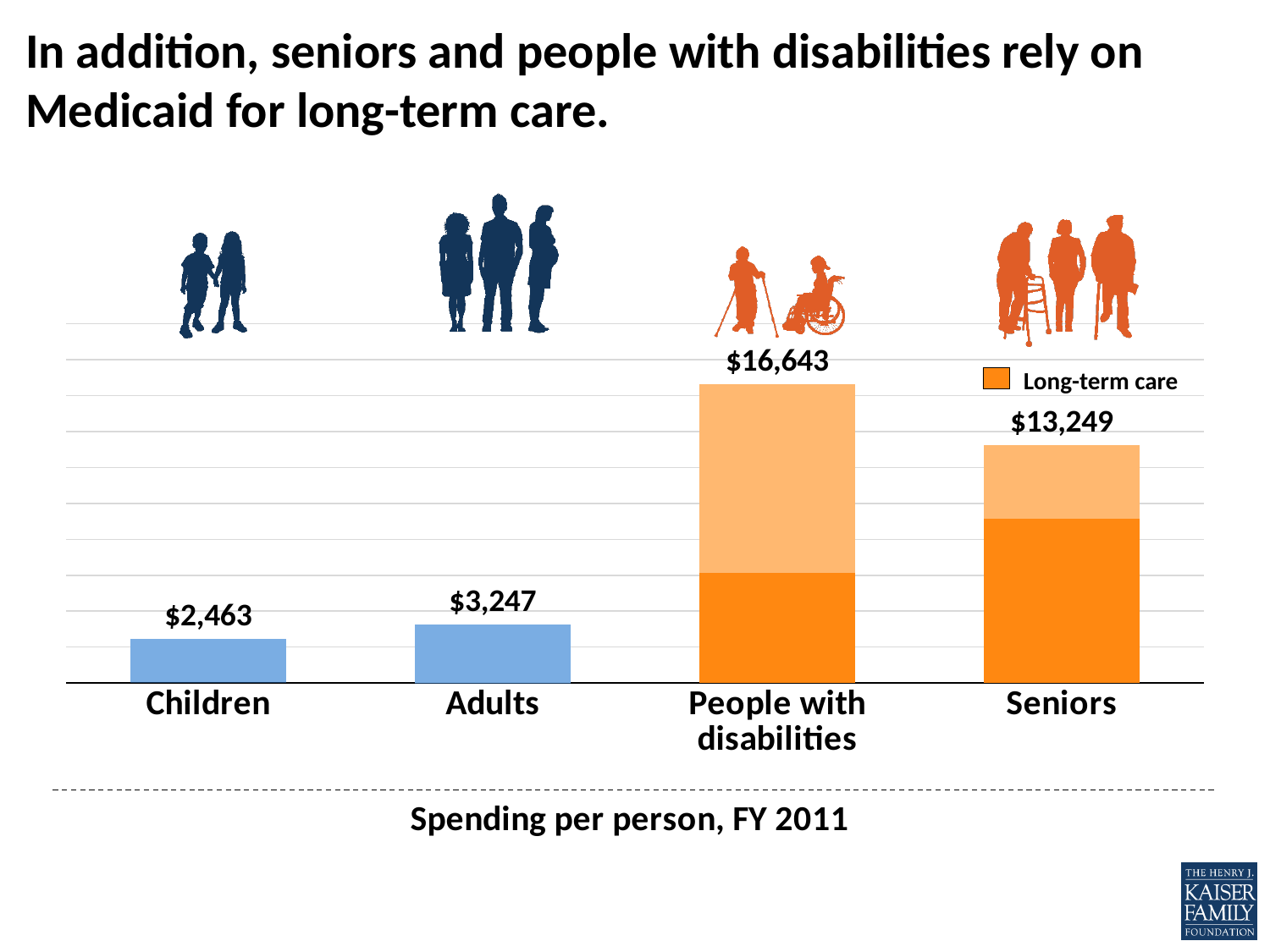
Which category has the highest spending per person? People with disabilities What does the legend entry on the chart say? Long-term care How many categories are shown on the x axis of the chart? 4 What is the spending per person for Children? $2,463 What is the spending per person for Seniors? $13,249 What is the difference in spending per person between People with disabilities and Seniors? $3,394 What is the difference in spending per person between Adults and Children? $784 What is the spending per person for People with disabilities? $16,643 Which has higher spending per person, Seniors or Adults? Seniors Which category has the lowest spending per person? Children What is the spending per person for Adults? $3,247 What kind of chart is shown on the slide? Bar chart